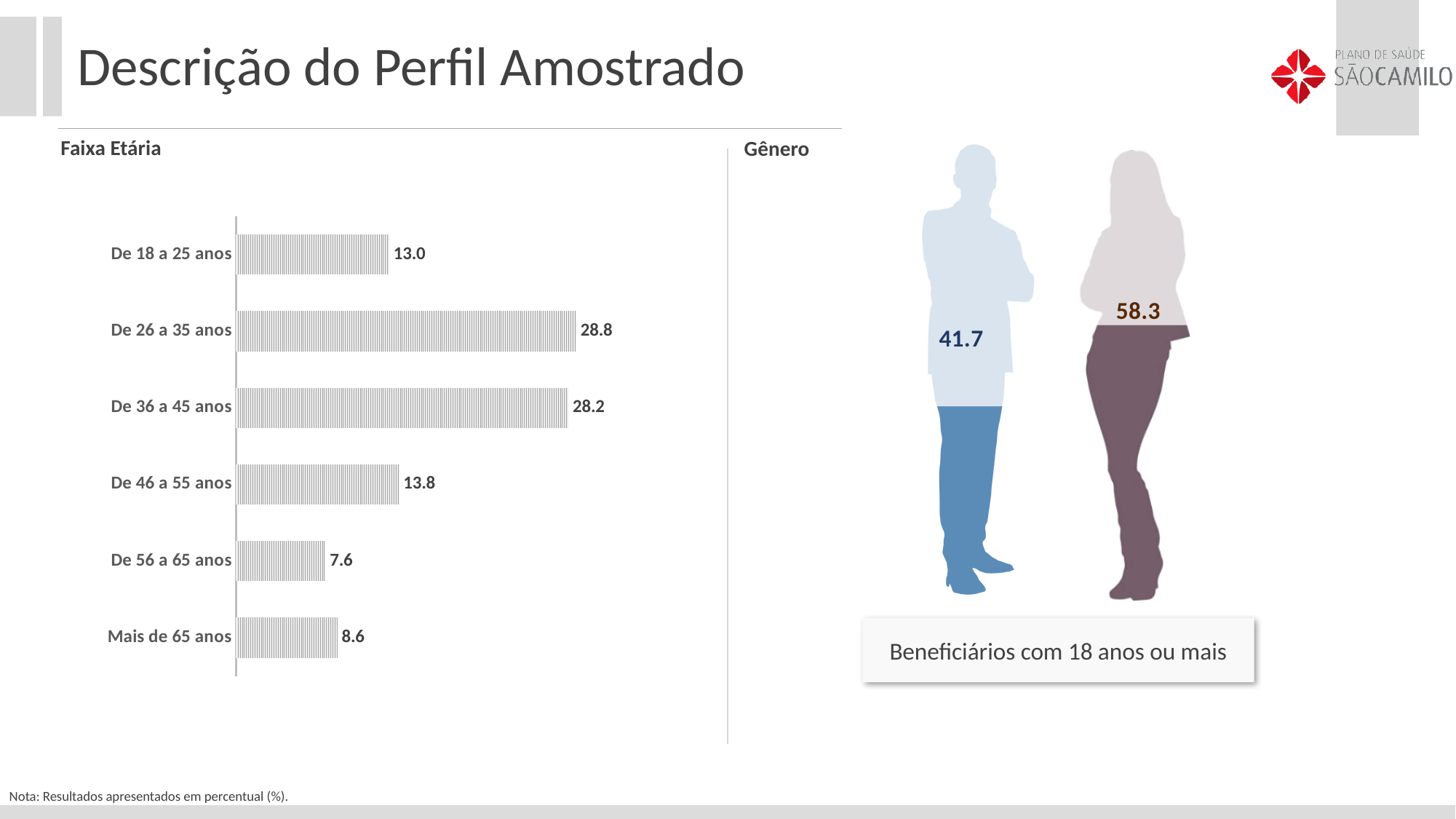
In the Faixa Etária chart, what is the value for De 46 a 55 anos? 13.8 In the Faixa Etária chart, what is the difference between the values for De 26 a 35 anos and De 36 a 45 anos? 0.6 How many age groups are shown in the Faixa Etária chart? 6 In the Faixa Etária chart, which age group has the lowest value? De 56 a 65 anos In the Faixa Etária chart, what is the difference between the values for De 46 a 55 anos and De 18 a 25 anos? 0.8 In the Gênero figure, what is the value shown for the male silhouette? 41.7 What kind of chart is the Faixa Etária chart? Bar chart In the Faixa Etária chart, which is larger: the value for De 56 a 65 anos or Mais de 65 anos? Mais de 65 anos In the Gênero figure, what is the value shown for the female silhouette? 58.3 In the Faixa Etária chart, what is the value for Mais de 65 anos? 8.6 In the Faixa Etária chart, what is the value for De 26 a 35 anos? 28.8 In the Faixa Etária chart, which age group has the highest value? De 26 a 35 anos